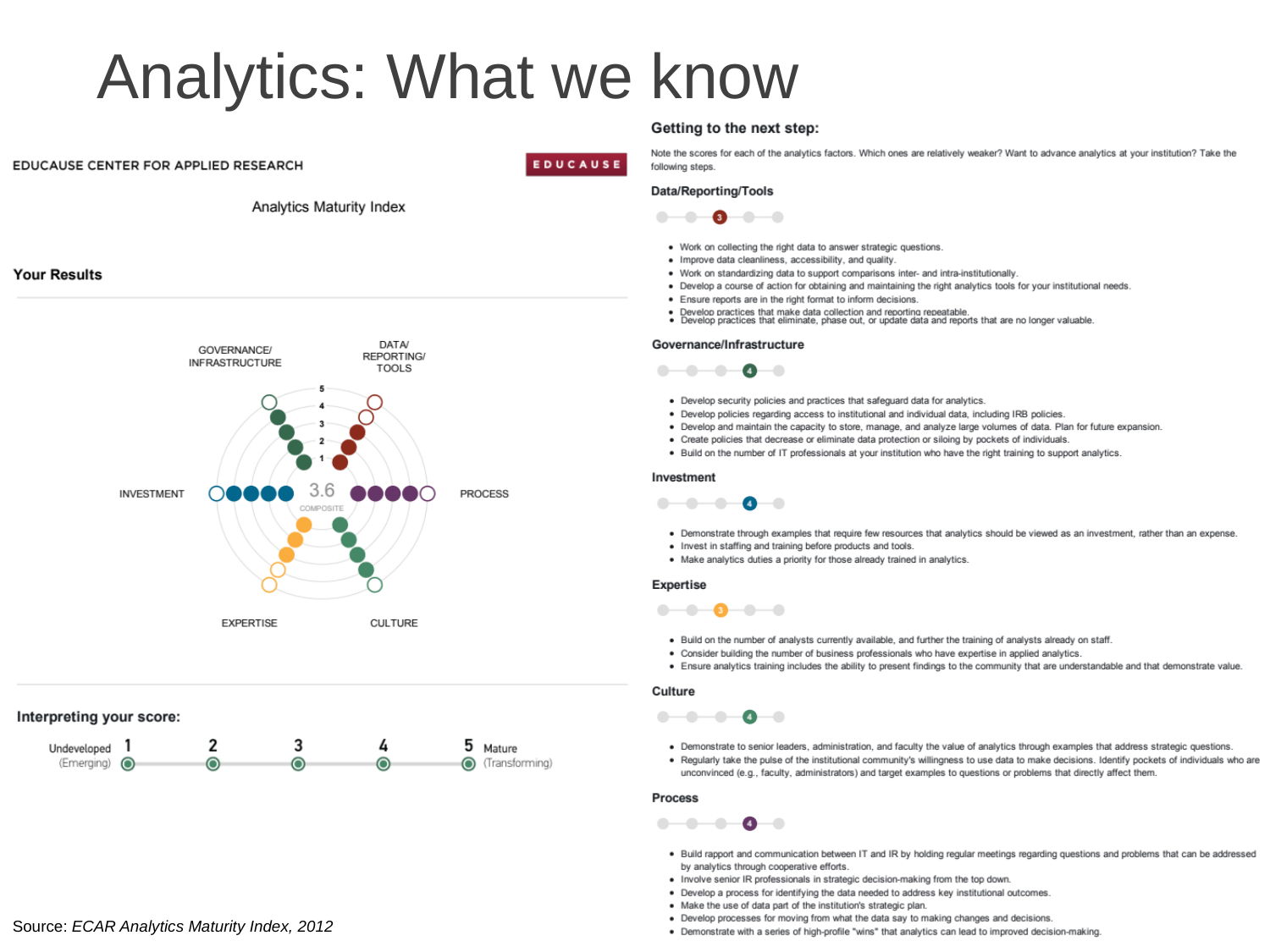
What score is shown for Governance/Infrastructure? 4 How many analytics factors are plotted around the Analytics Maturity Index chart? 6 Which has the higher score, Governance/Infrastructure or Expertise? Governance/Infrastructure What kind of chart is used to display the six analytics factor scores? radar chart What is the difference between the Culture score and the Data/Reporting/Tools score? 1 What is the maximum value on the maturity scale shown in the chart? 5 What is the composite score shown at the centre of the Analytics Maturity Index chart? 3.6 What score is shown for Data/Reporting/Tools? 3 Is the composite score greater or less than 3? greater What score is shown for Expertise? 3 What score is shown for Process? 4 What is the title of the chart on the left of the slide? Analytics Maturity Index